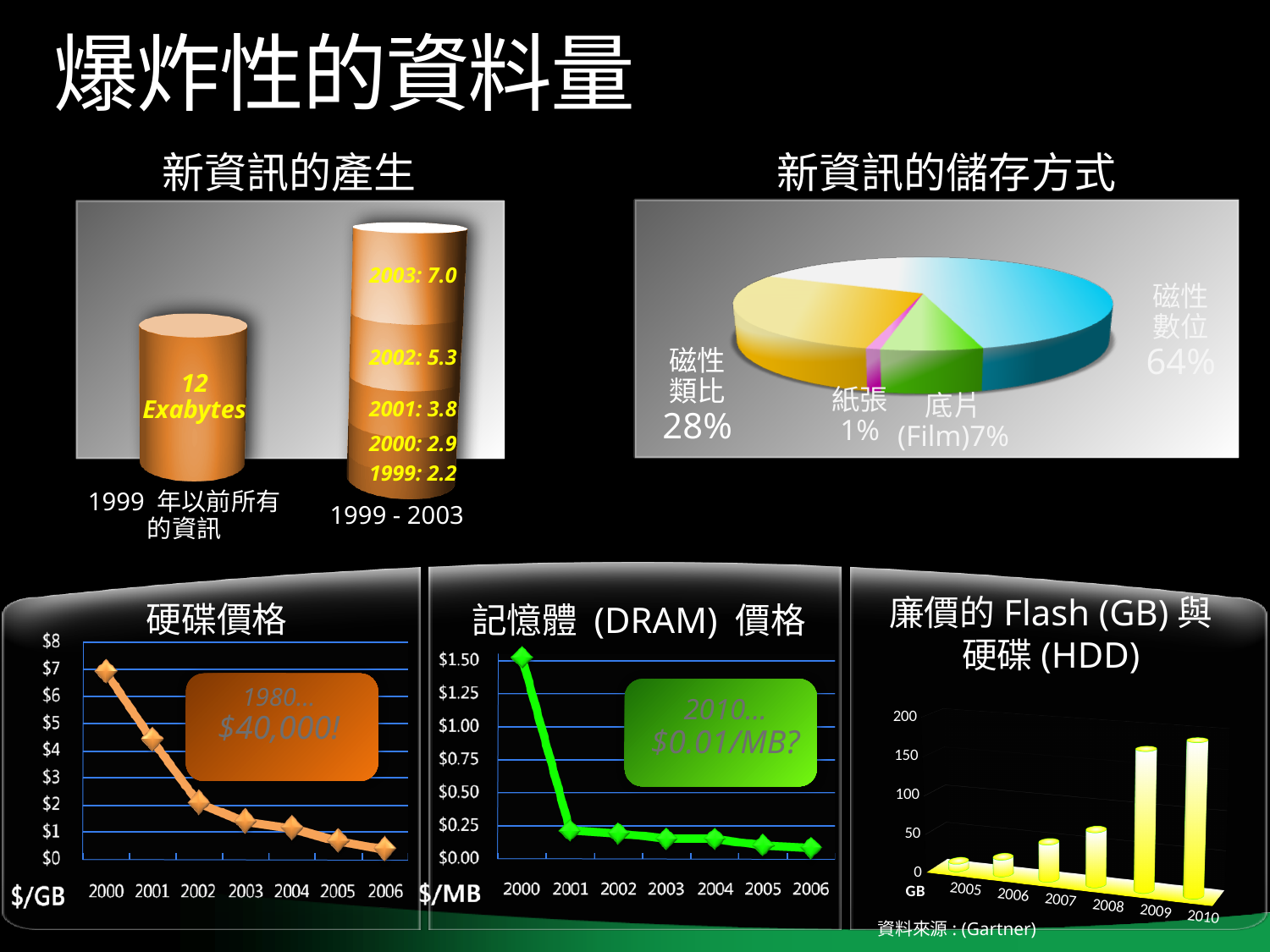
In the pie chart titled 新資訊的儲存方式, how many slices are shown? 4 In the chart titled 廉價的 Flash (GB) 與硬碟 (HDD), how many years are shown on the x axis? 6 In the chart titled 新資訊的產生, what is the total of the stacked 1999 - 2003 cylinder? 21.2 In the chart titled 硬碟價格, what kind of chart is it? line chart In the pie chart titled 新資訊的儲存方式, what share does 磁性數位 have? 64% In the chart titled 廉價的 Flash (GB) 與硬碟 (HDD), which year has the highest bar? 2010 In the pie chart titled 新資訊的儲存方式, which category has the smallest slice? 紙張 In the chart titled 新資訊的產生, what is the value labelled for 2003? 7.0 In the chart titled 記憶體 (DRAM) 價格, is the value for 2001 greater or less than $0.50? less In the chart titled 記憶體 (DRAM) 價格, do the values rise or fall from 2000 to 2006? fall In the chart titled 新資訊的產生, what is the difference between the 2003 value and the 1999 value? 4.8 In the chart titled 硬碟價格, is the value for 2000 greater or less than $6? greater